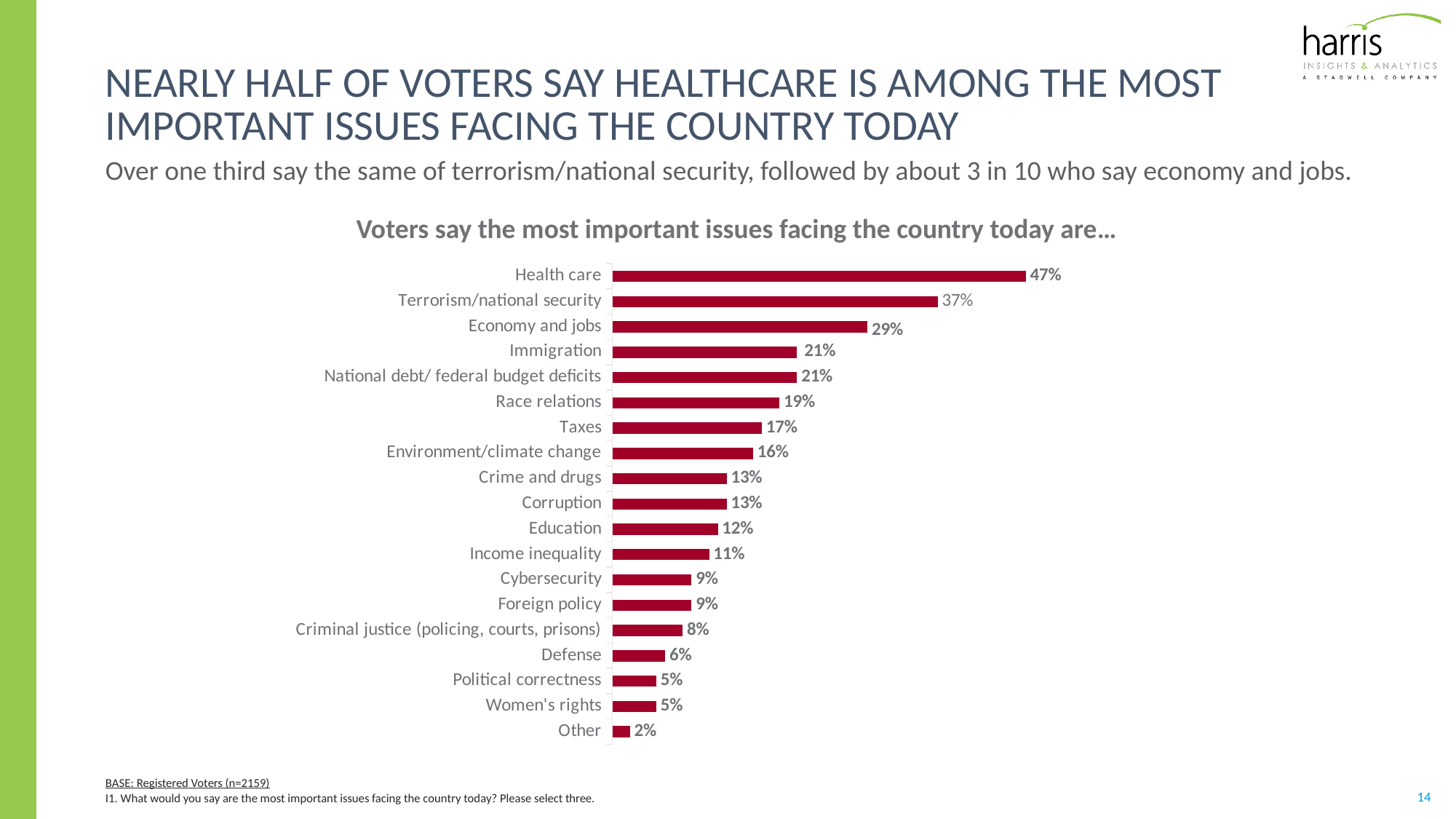
What is the value shown for Criminal justice (policing, courts, prisons)? 8% What is the difference in percentage points between Health care and Economy and jobs? 18 What is the difference in percentage points between Immigration and Defense? 15 What is the title of the chart? Voters say the most important issues facing the country today are… Which issue has the highest percentage in the chart? Health care What is the value shown for Terrorism/national security? 37% What percentage is shown for Environment/climate change? 16% Which category has the lowest percentage in the chart? Other Which has a higher value, Race relations or Taxes? Race relations What type of chart is shown on the slide? Bar chart How many categories are shown in the chart? 19 What percentage of voters say health care is among the most important issues facing the country today? 47%